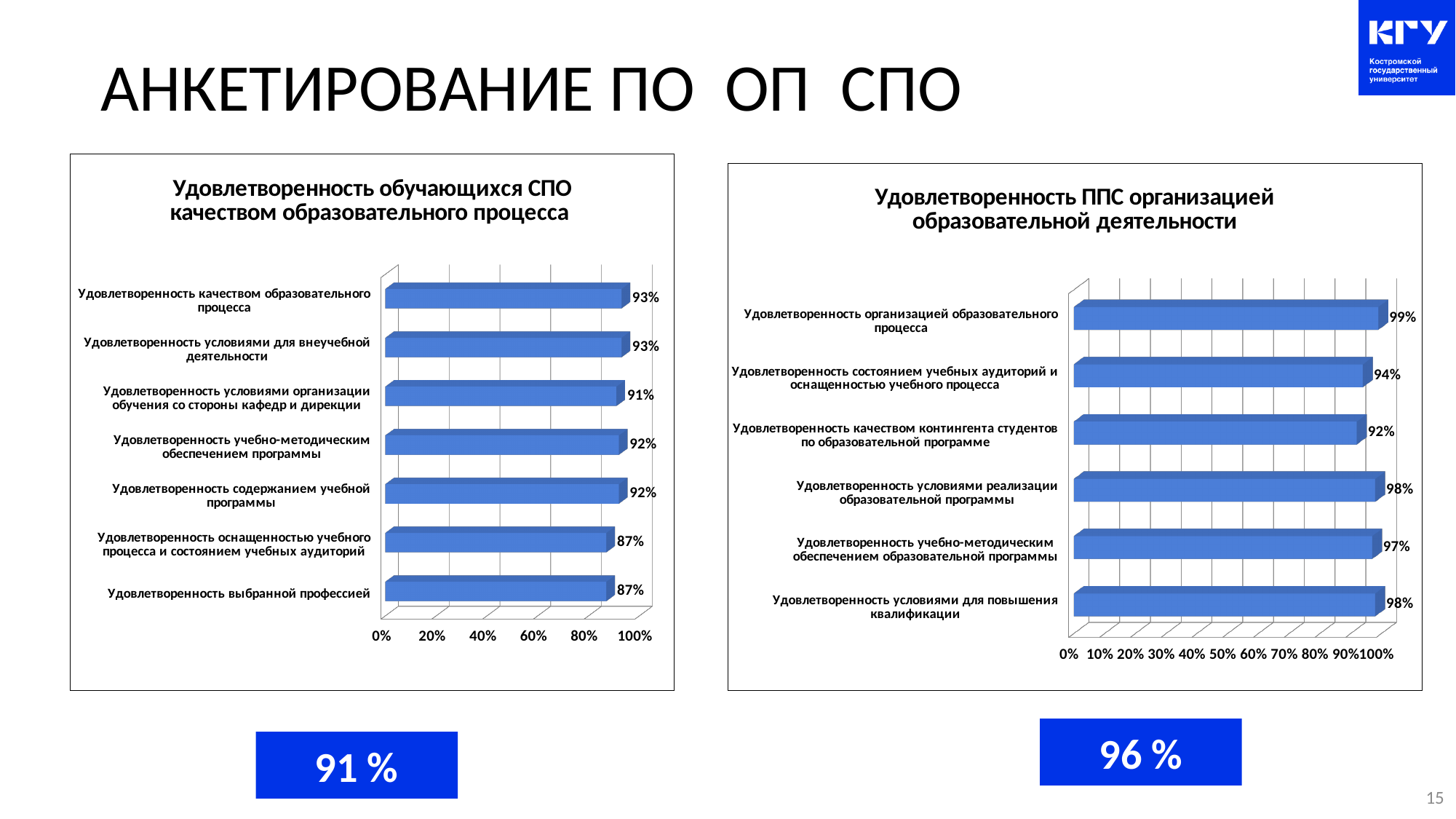
In the chart 'Удовлетворенность ППС организацией образовательной деятельности', which category has the lowest value? Удовлетворенность качеством контингента студентов по образовательной программе In the chart 'Удовлетворенность обучающихся СПО качеством образовательного процесса', what is the value for 'Удовлетворенность выбранной профессией'? 87% In the chart 'Удовлетворенность ППС организацией образовательной деятельности', what is the difference between 'Удовлетворенность организацией образовательного процесса' and 'Удовлетворенность качеством контингента студентов по образовательной программе'? 7% In the chart 'Удовлетворенность обучающихся СПО качеством образовательного процесса', what type of chart is shown? Bar chart What is the title of the chart on the left side of the slide? Удовлетворенность обучающихся СПО качеством образовательного процесса In the chart 'Удовлетворенность обучающихся СПО качеством образовательного процесса', what is the value for 'Удовлетворенность условиями организации обучения со стороны кафедр и дирекции'? 91% In the chart 'Удовлетворенность обучающихся СПО качеством образовательного процесса', what is the difference between 'Удовлетворенность качеством образовательного процесса' and 'Удовлетворенность оснащенностью учебного процесса и состоянием учебных аудиторий'? 6% In the chart 'Удовлетворенность ППС организацией образовательной деятельности', how many categories are plotted? 6 In the chart 'Удовлетворенность ППС организацией образовательной деятельности', what is the value for 'Удовлетворенность учебно-методическим обеспечением образовательной программы'? 97% In the chart 'Удовлетворенность ППС организацией образовательной деятельности', which category has the highest value? Удовлетворенность организацией образовательного процесса In the chart 'Удовлетворенность обучающихся СПО качеством образовательного процесса', how many categories are plotted? 7 In the chart 'Удовлетворенность ППС организацией образовательной деятельности', which is larger: 'Удовлетворенность состоянием учебных аудиторий и оснащенностью учебного процесса' or 'Удовлетворенность условиями реализации образовательной программы'? Удовлетворенность условиями реализации образовательной программы